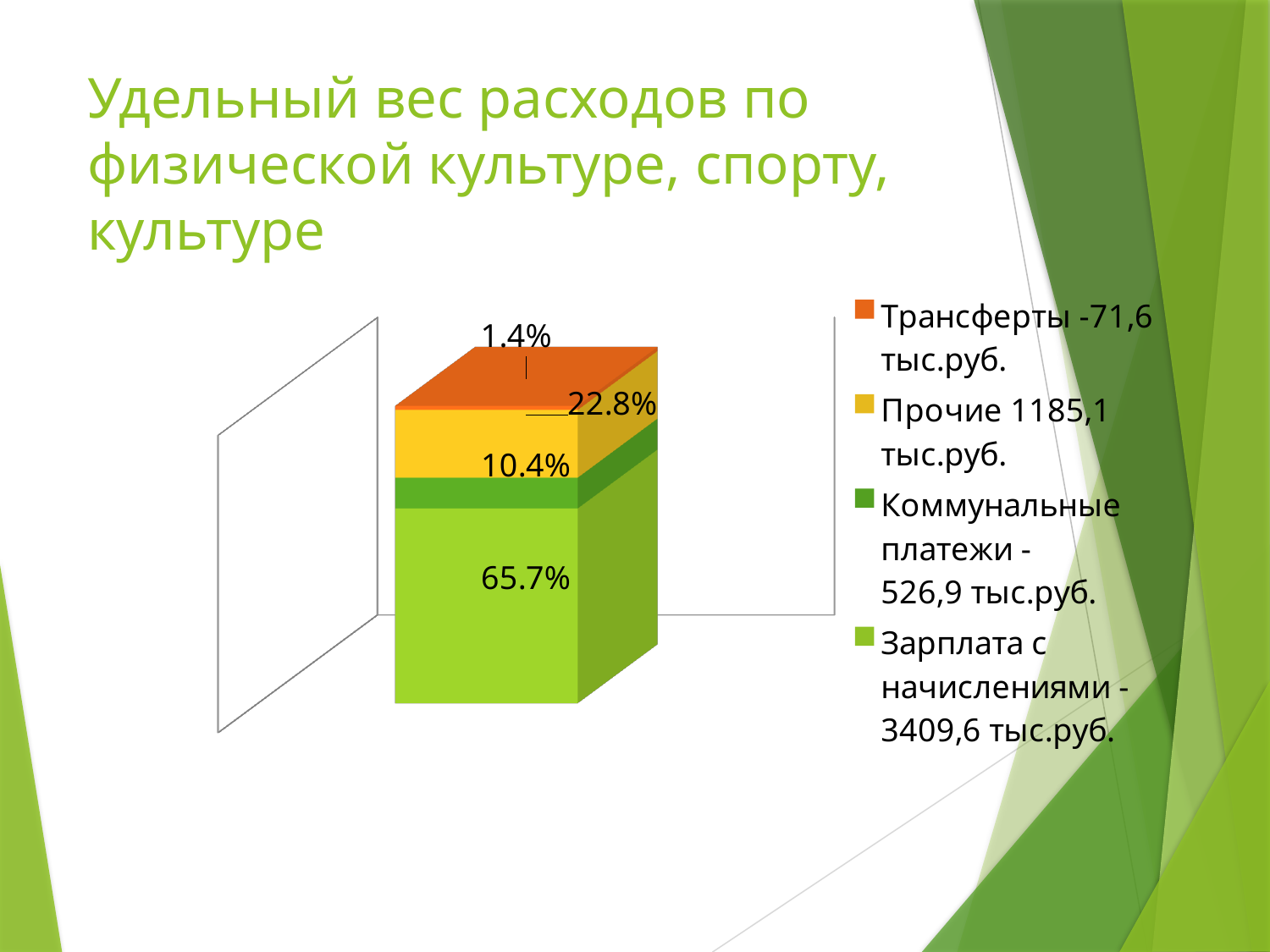
What percentage is shown for Трансферты? 1.4% According to the legend, what amount in тыс.руб. is given for Трансферты? 71,6 тыс.руб. What percentage is shown for Зарплата с начислениями? 65.7% According to the legend, what amount in тыс.руб. is given for Коммунальные платежи? 526,9 тыс.руб. Which expense category has the largest share? Зарплата с начислениями Which expense category has the smallest share? Трансферты What percentage is shown for Прочие? 22.8% What is the difference in percentage points between Зарплата с начислениями and Прочие? 42.9 How many series does the legend list? 4 Which is larger, the share for Прочие or the share for Коммунальные платежи? Прочие What kind of chart is shown on the slide? bar chart What percentage is shown for Коммунальные платежи? 10.4%